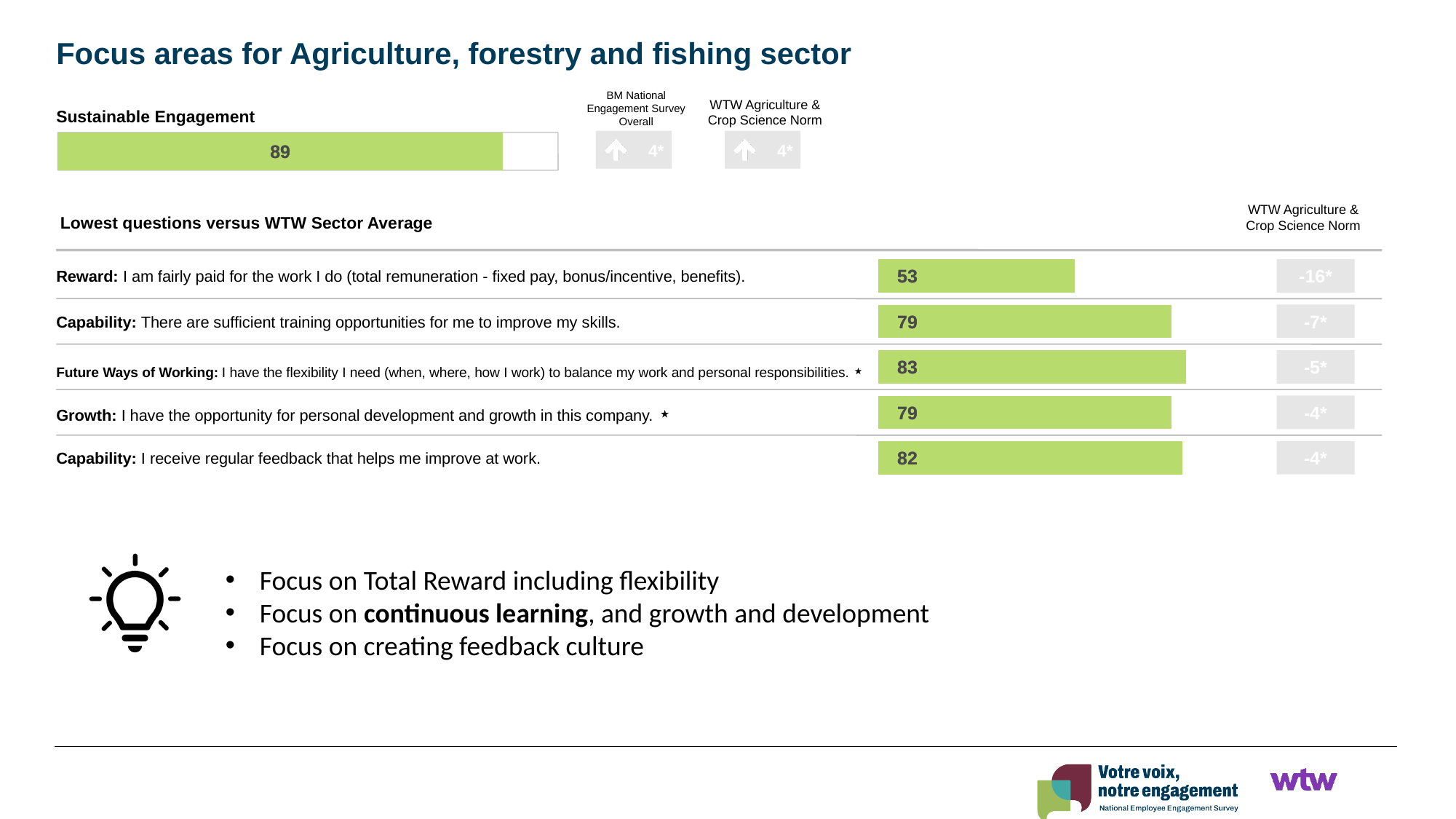
How many questions are listed in the Lowest questions versus WTW Sector Average chart? 5 In the Lowest questions versus WTW Sector Average chart, which is larger: the score for the Capability training question or the score for the Capability feedback question? Capability feedback question (82) In the Sustainable Engagement chart, what value is shown against the BM National Engagement Survey Overall comparison? 4* In the Lowest questions versus WTW Sector Average chart, what is the score for the Future Ways of Working question about flexibility? 83 In the Lowest questions versus WTW Sector Average chart, what is the difference between the Future Ways of Working score and the Reward score? 30 In the Sustainable Engagement chart, what is the Sustainable Engagement score shown on the bar? 89 In the Lowest questions versus WTW Sector Average chart, which question has the highest score? Future Ways of Working: I have the flexibility I need In the Lowest questions versus WTW Sector Average chart, what is the score for the Reward question 'I am fairly paid for the work I do'? 53 In the Lowest questions versus WTW Sector Average chart, which question has the lowest score? Reward: I am fairly paid for the work I do In the Lowest questions versus WTW Sector Average chart, what is the WTW Agriculture & Crop Science Norm difference shown for the Reward question? -16* What kind of chart is used to show the scores in the Lowest questions versus WTW Sector Average section? Bar chart In the Lowest questions versus WTW Sector Average chart, what is the score for the Capability question 'I receive regular feedback that helps me improve at work'? 82